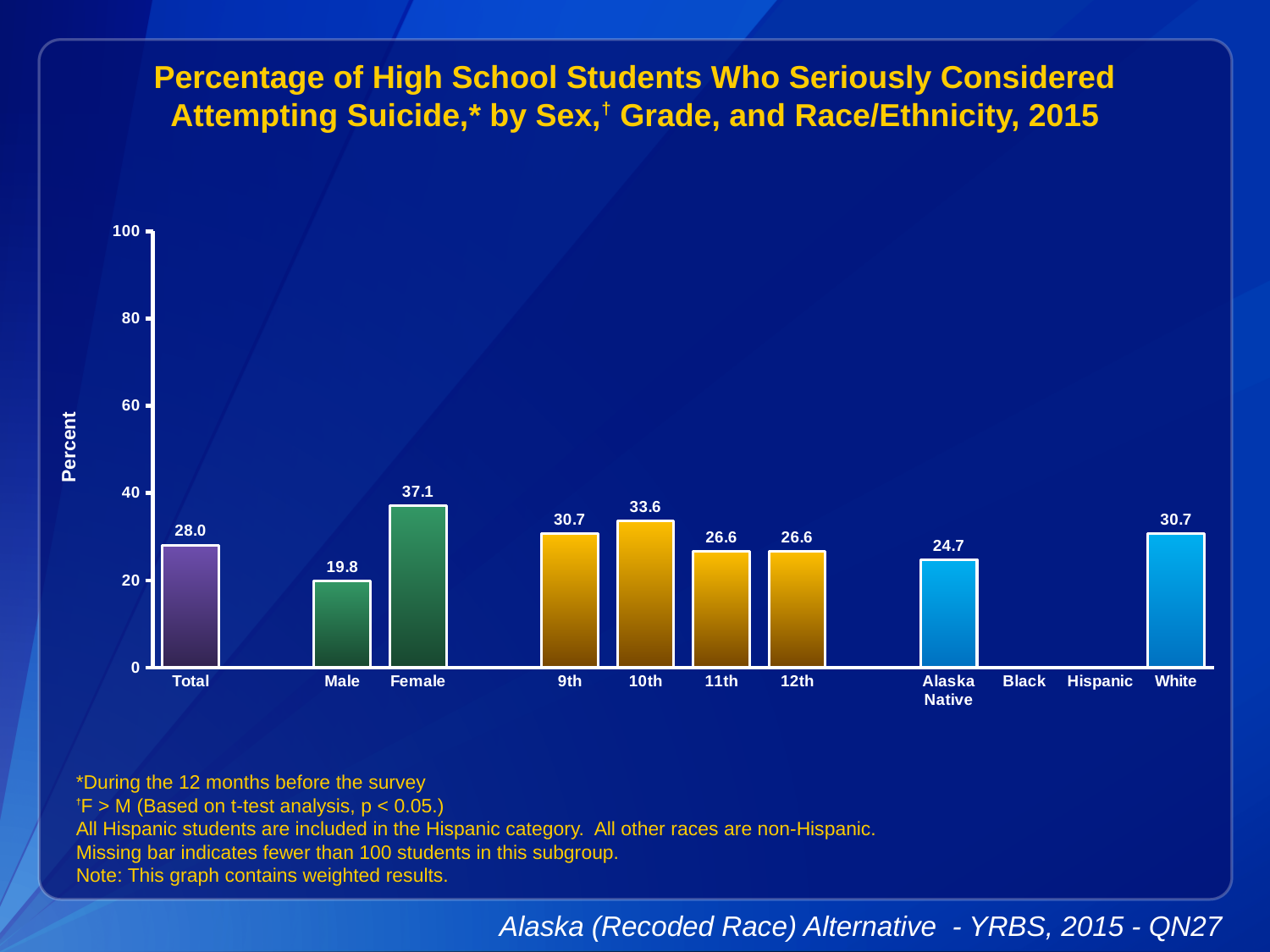
What is the value for Female? 37.1 Which categories have no bar shown? Black and Hispanic Which category with a bar has the lowest value? Male What is the value for Alaska Native? 24.7 What is the value for Total? 28.0 What is the difference between the Female and Male values? 17.3 What kind of chart is shown? bar chart How many categories are labeled on the x axis? 11 Which is larger, the value for 9th or the value for 10th? 10th Which category has the highest value? Female What is the label on the y axis? Percent Is the value for 12th greater or less than 40? less